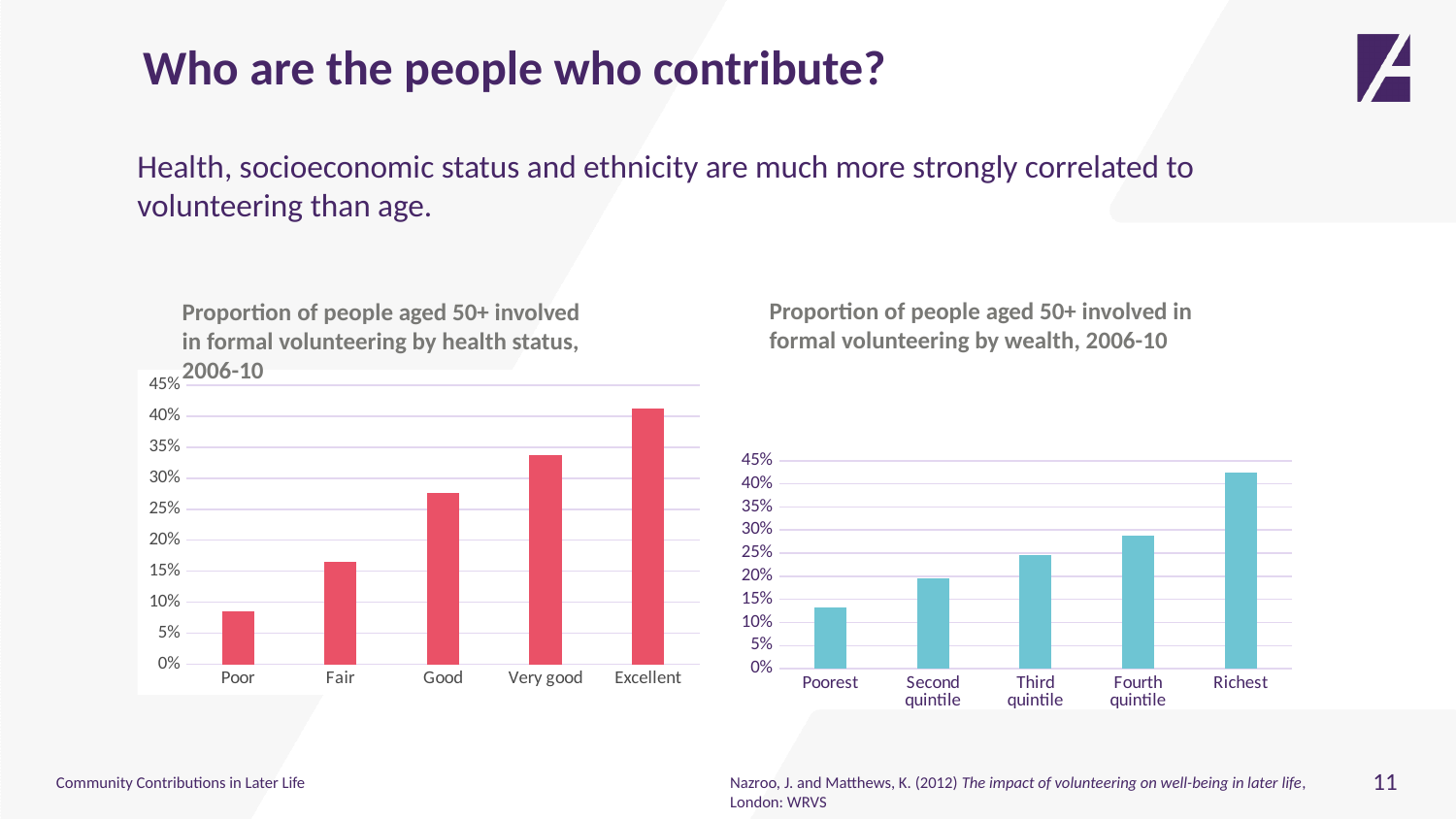
In the chart on the right (by wealth), which is larger, the value for Fourth quintile or the value for Second quintile? Fourth quintile In the chart on the left (by health status), do the values rise or fall from Poor to Excellent? rise What type of chart is the chart on the right (by wealth)? bar chart In the chart on the left (by health status), is the value for Poor greater or less than 10%? less In the chart on the left (by health status), which health status category has the highest proportion of people involved in formal volunteering? Excellent In the chart on the left (by health status), is the value for Good greater or less than 25%? greater In the chart on the left (by health status), which health status category has the lowest proportion? Poor In the chart on the right (by wealth), which wealth group has the highest proportion of people involved in formal volunteering? Richest In the chart on the right (by wealth), which wealth group has the lowest proportion? Poorest In the chart on the right (by wealth), is the value for Poorest greater or less than 15%? less In the chart on the left (by health status), how many health status categories are shown? 5